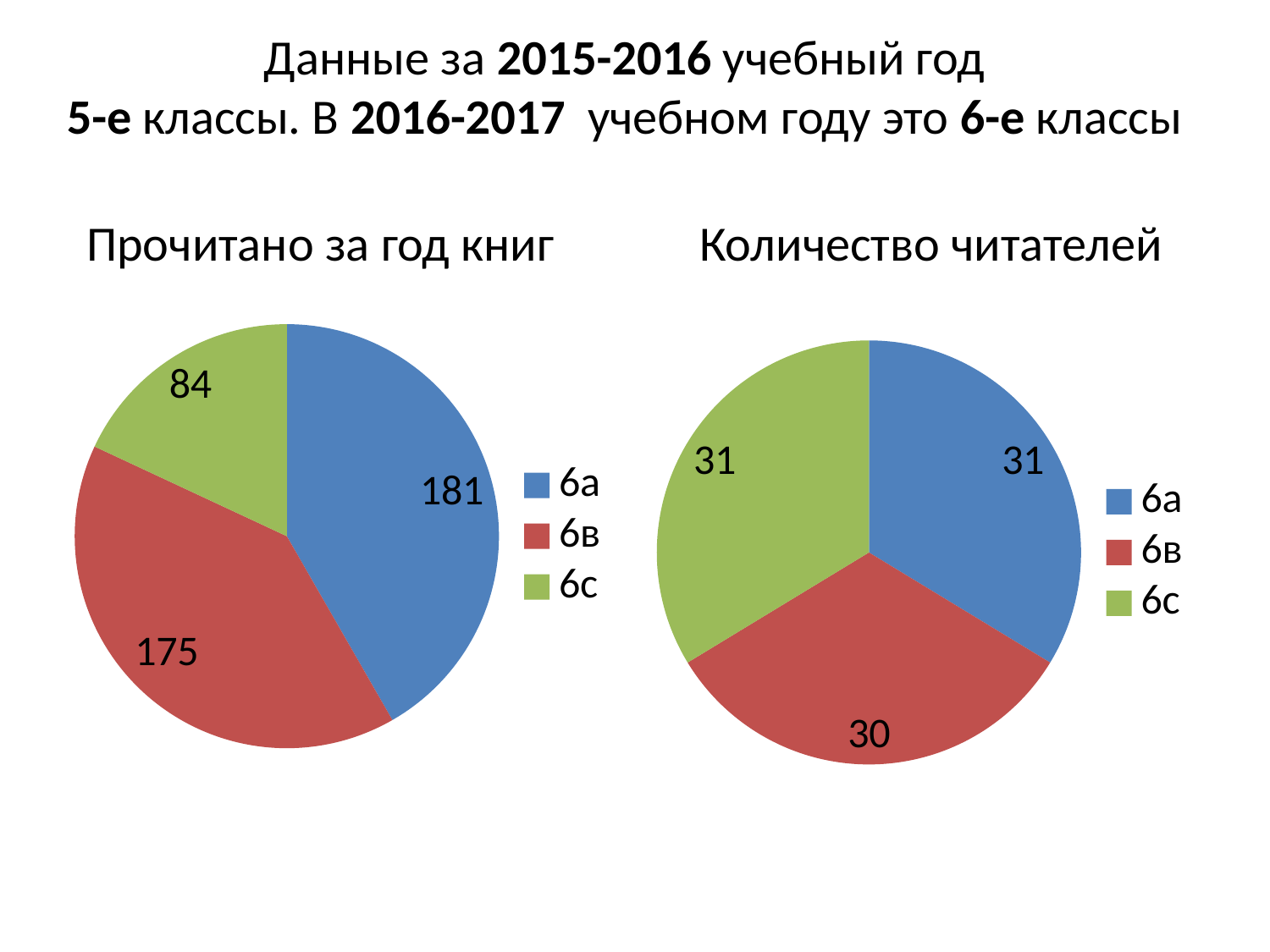
In the chart titled "Прочитано за год книг", what is the value for 6а? 181 In the chart titled "Количество читателей", what colour is the slice for 6с? green What kind of chart is the chart titled "Прочитано за год книг"? pie chart In the chart titled "Прочитано за год книг", what is the value for 6с? 84 In the chart titled "Прочитано за год книг", which category has the highest value? 6а In the chart titled "Количество читателей", what is the value for 6в? 30 In the chart titled "Прочитано за год книг", what is the difference between the values for 6а and 6в? 6 How many slices does the chart titled "Количество читателей" have? 3 In the chart titled "Прочитано за год книг", what is the difference between the values for 6в and 6с? 91 In the chart titled "Прочитано за год книг", which category has the lowest value? 6с In the chart titled "Прочитано за год книг", which is larger, the value for 6в or the value for 6с? 6в In the chart titled "Количество читателей", which is larger, the value for 6а or the value for 6в? 6а